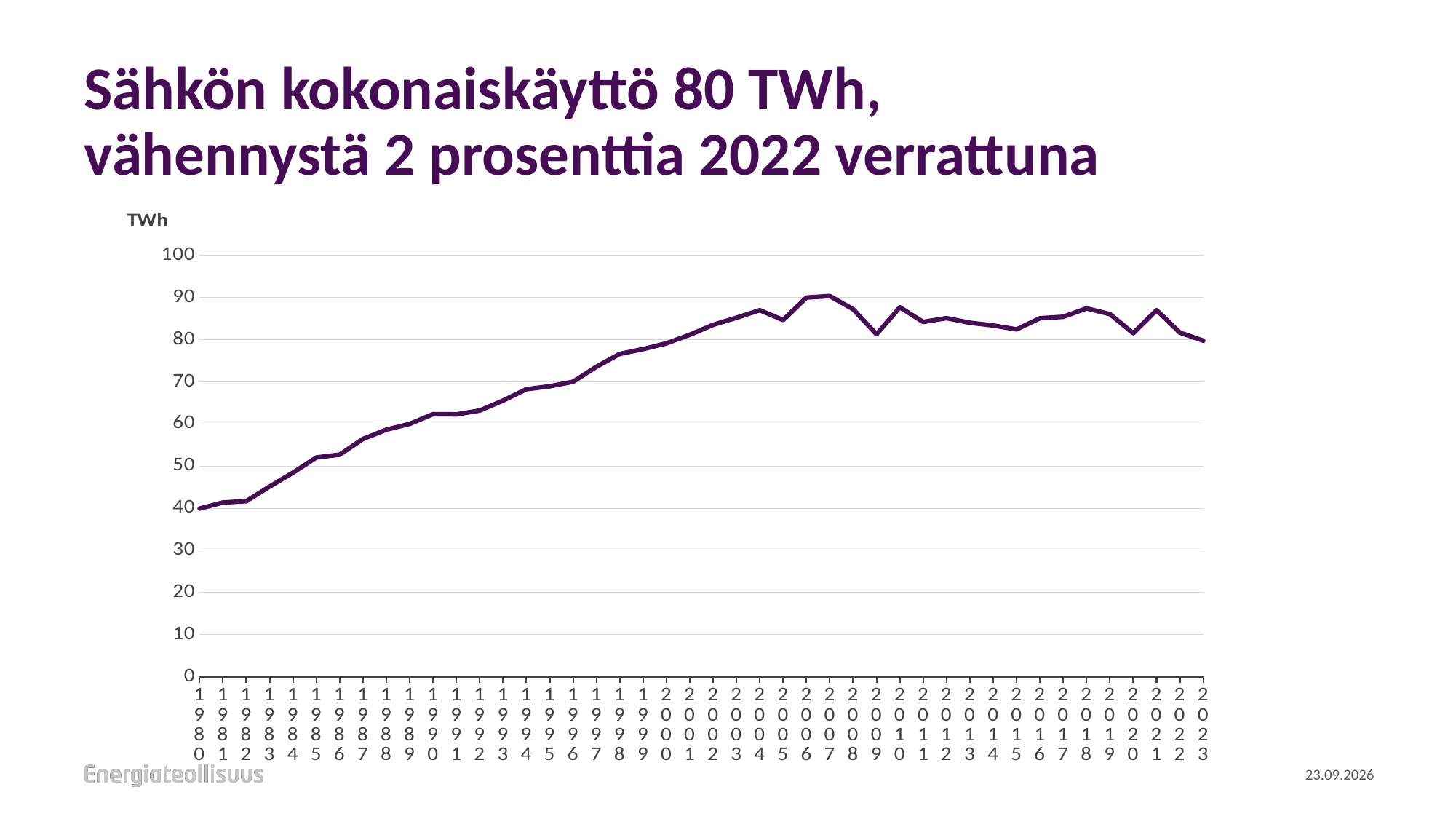
Does the line generally rise or fall from 1980 to 2007? rise Which year has the larger value, 1980 or 2023? 2023 Which year has the lowest electricity consumption in the chart? 1980 What unit is shown on the y axis of the chart? TWh How many years (data points) are plotted on the x axis? 44 What kind of chart is shown on the slide? line chart Is the value for 1980 greater or less than 50 TWh? less Is the value for 1990 greater or less than 50 TWh? greater Is the value for 2000 greater or less than 70 TWh? greater Which year has the larger value, 2009 or 2010? 2010